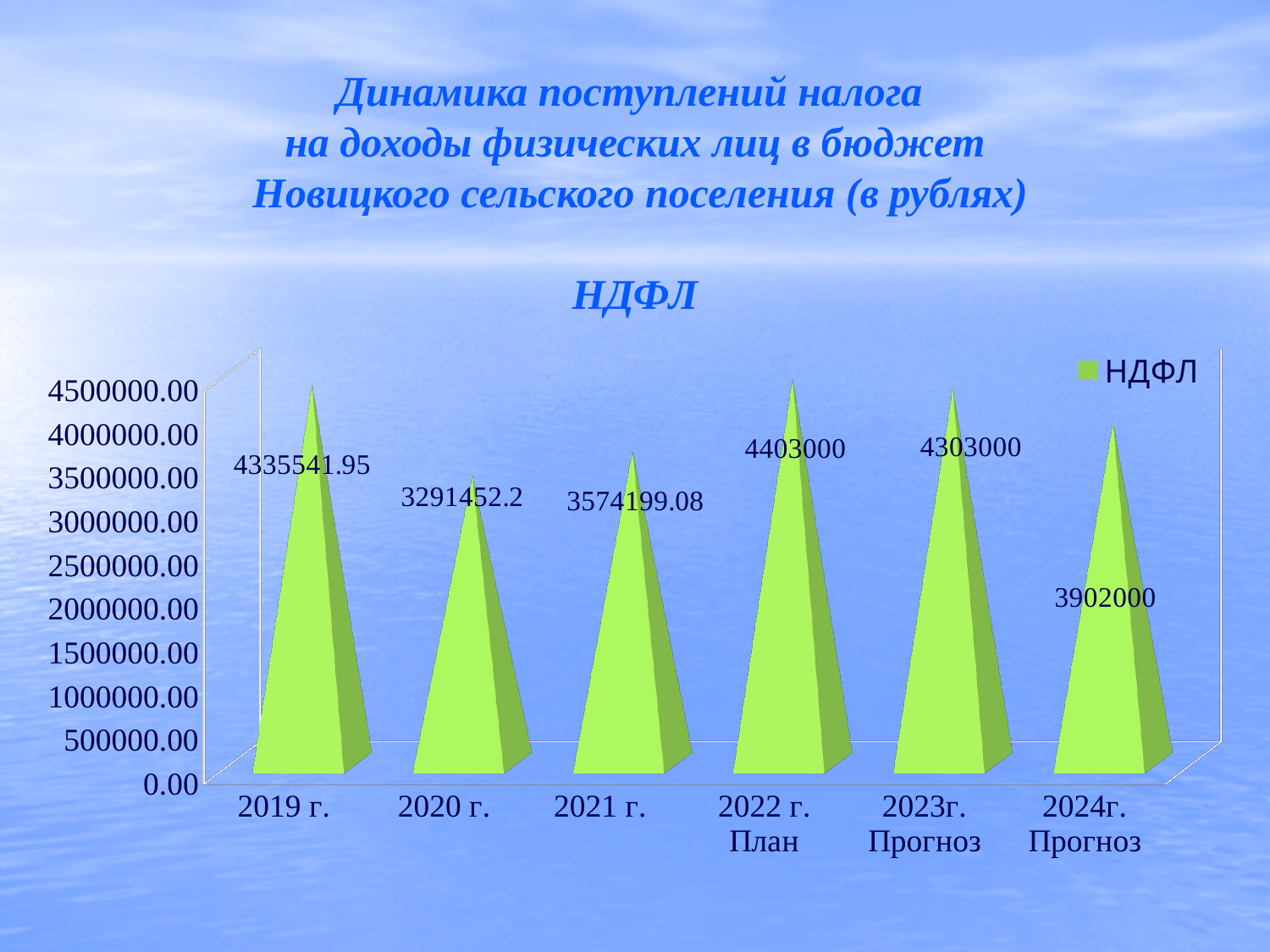
What is the difference between the values for 2022 г. План and 2023г. Прогноз? 100000 Which category has the lowest value? 2020 г. What is the value for 2024г. Прогноз? 3902000 What is the value for 2022 г. План? 4403000 Which is larger, the value for 2021 г. or the value for 2020 г.? 2021 г. Which category has the highest value? 2022 г. План What is the value for 2019 г.? 4335541.95 What type of chart is shown on the slide? bar chart How many categories are shown on the x axis? 6 What is the name of the series listed in the legend? НДФЛ What is the value for 2020 г.? 3291452.2 Is the value for 2020 г. greater or less than 3500000.00? less